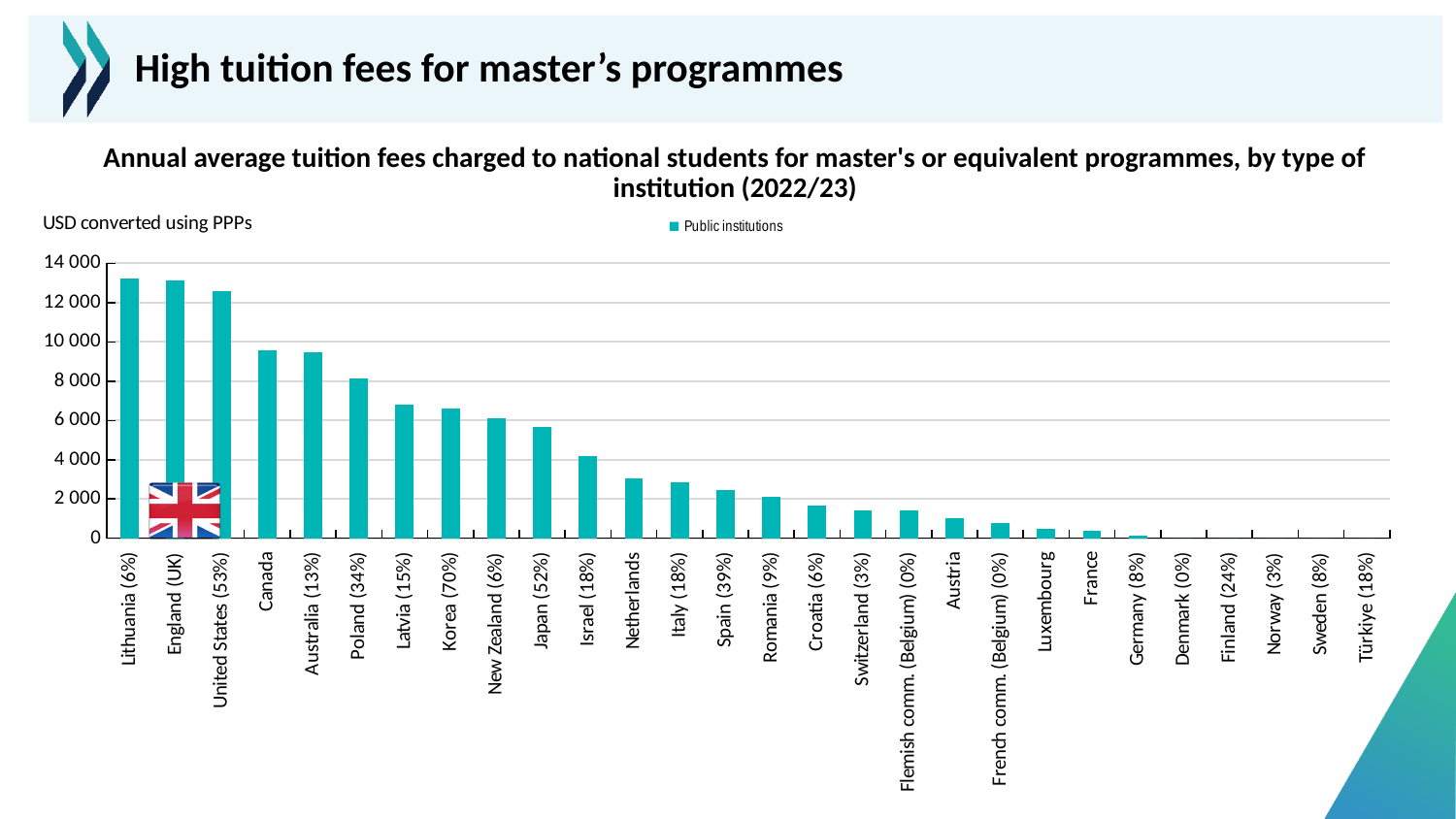
Which has the larger value, Korea (70%) or Japan (52%)? Korea (70%) Is the value for Netherlands greater or less than 2 000? greater Which has the larger value, Canada or Poland (34%)? Canada How many series does the legend list? 1 Is the value for Austria greater or less than 2 000? less What kind of chart is shown on the slide? bar chart Do the values rise or fall moving from left to right along the x axis? fall Is the value for Canada greater or less than 8 000? greater How many countries or regions are shown on the x axis? 28 What is the name of the series shown in the legend? Public institutions